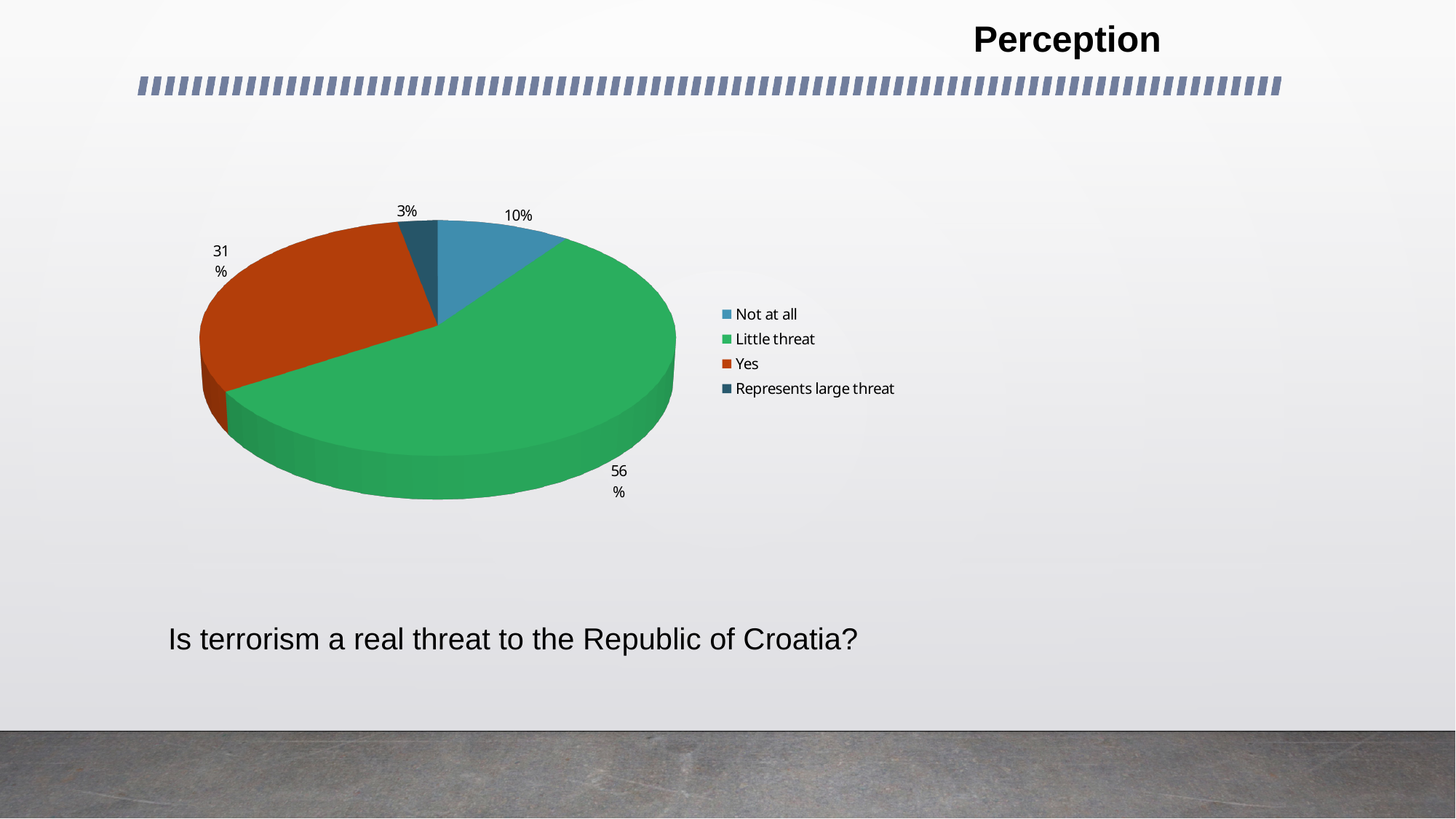
What percentage of the pie is labelled "Not at all"? 10% What percentage of the pie is labelled "Little threat"? 56% What question does the chart on the slide answer? Is terrorism a real threat to the Republic of Croatia? What colour is the "Yes" slice? Orange-red Which slice is larger, "Not at all" or "Yes"? Yes How many categories does the legend list? 4 What percentage of the pie is labelled "Yes"? 31% Which category has the smallest slice of the pie? Represents large threat What percentage of the pie is labelled "Represents large threat"? 3% Which category has the largest slice of the pie? Little threat What is the difference in percentage points between the "Little threat" and "Yes" slices? 25 What kind of chart is shown on the slide? Pie chart